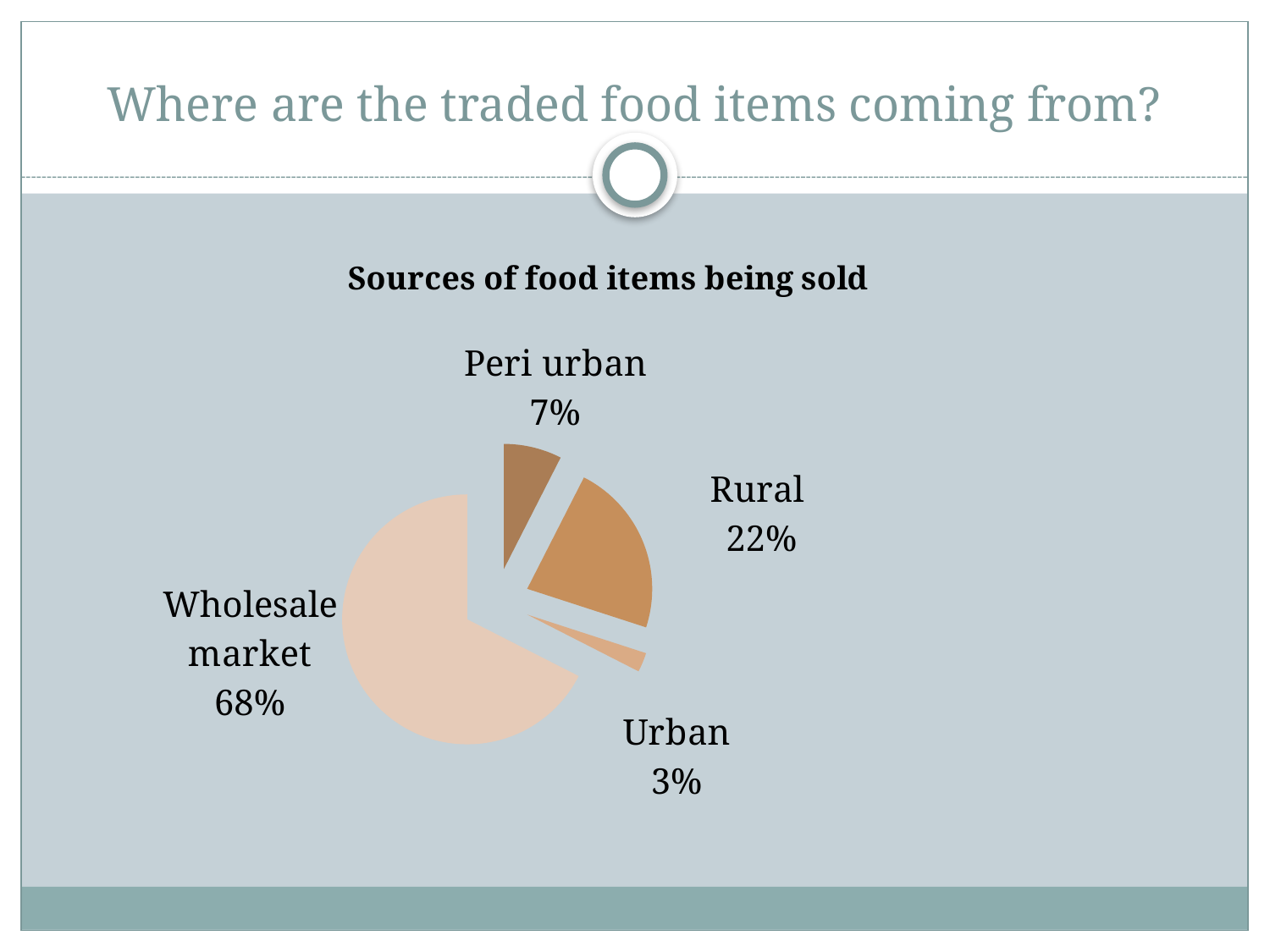
What share of food items being sold comes from rural sources? 22% Which source accounts for the largest share of food items being sold? Wholesale market Which is larger, the share from rural sources or the share from peri urban sources? Rural What share of food items being sold comes from urban sources? 3% Which source accounts for the smallest share of food items being sold? Urban What kind of chart is shown on the slide? Pie chart What is the title of the chart? Sources of food items being sold How many sources are shown in the pie chart? 4 What share of food items being sold comes from the wholesale market? 68% What is the difference in percentage points between the wholesale market share and the rural share? 46 percentage points What is the combined share of rural and peri urban sources? 29% What share of food items being sold comes from peri urban sources? 7%